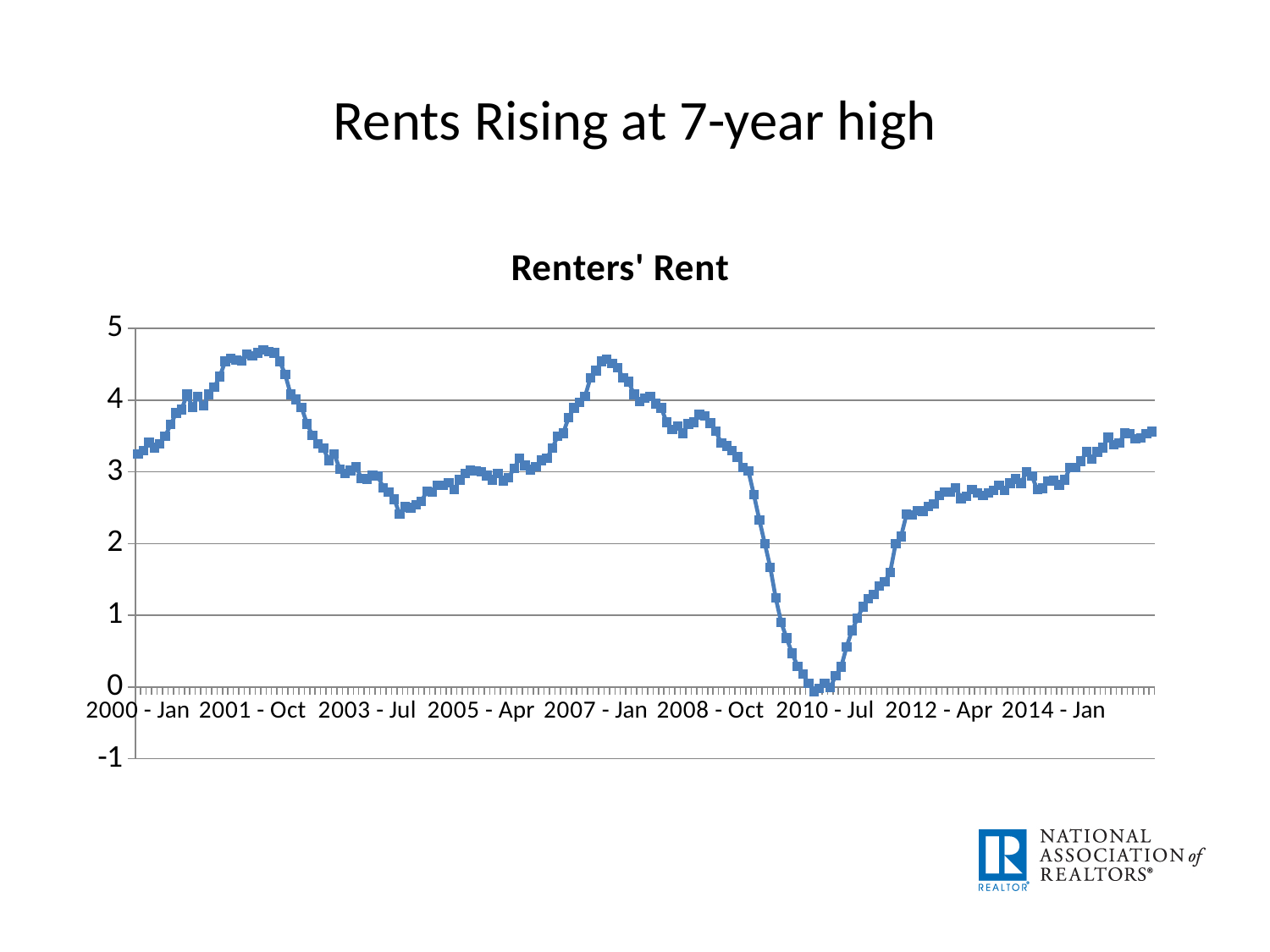
Is the value for 2014 - Jan greater or less than 2? greater Does the line rise or fall between 2008 - Oct and 2010 - Jul? fall Is the value for 2008 - Oct greater or less than 4? less Is the value for 2003 - Jul greater or less than 4? less Does the line rise or fall between 2010 - Jul and 2012 - Apr? rise What is the highest value shown on the vertical axis? 5 What kind of chart is shown on the slide? line chart Which of the two is larger: the value at 2000 - Jan or the value at 2010 - Jul? 2000 - Jan What is the title of the chart? Renters' Rent